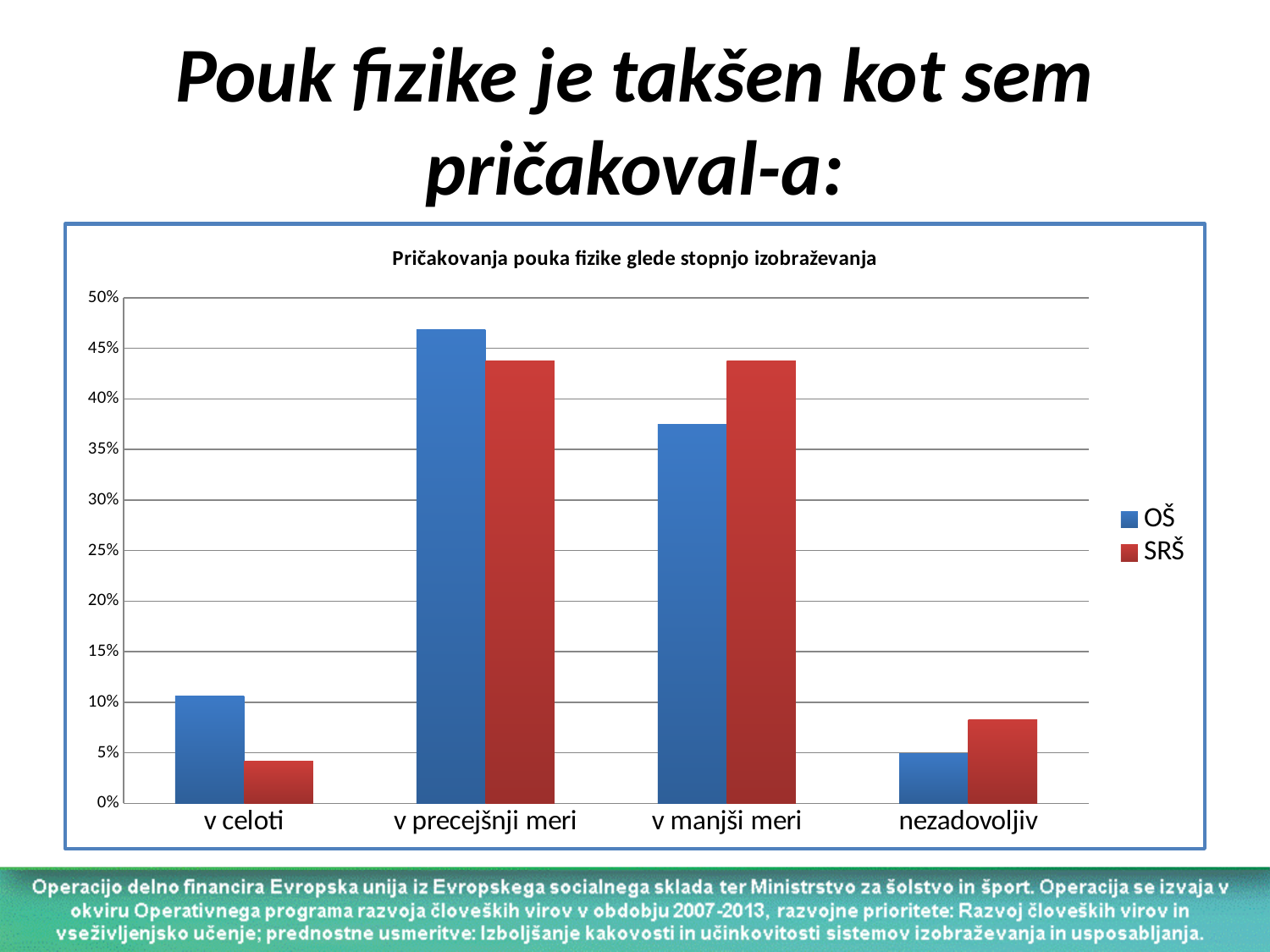
For the category 'v celoti', which series has the larger value, OŠ or SRŠ? OŠ For the category 'nezadovoljiv', which series has the larger value, OŠ or SRŠ? SRŠ How many series does the legend list? 2 Is the OŠ value for 'v manjši meri' greater or less than 40%? less Which category has the lowest value for the SRŠ series? v celoti For the category 'v manjši meri', which series has the larger value, OŠ or SRŠ? SRŠ Which category has the lowest value for the OŠ series? nezadovoljiv How many categories are shown on the x axis? 4 Which category has the highest value for the OŠ series? v precejšnji meri What is the title of the chart? Pričakovanja pouka fizike glede stopnjo izobraževanja What kind of chart is shown on the slide? bar chart Is the OŠ value for 'v precejšnji meri' greater or less than 45%? greater